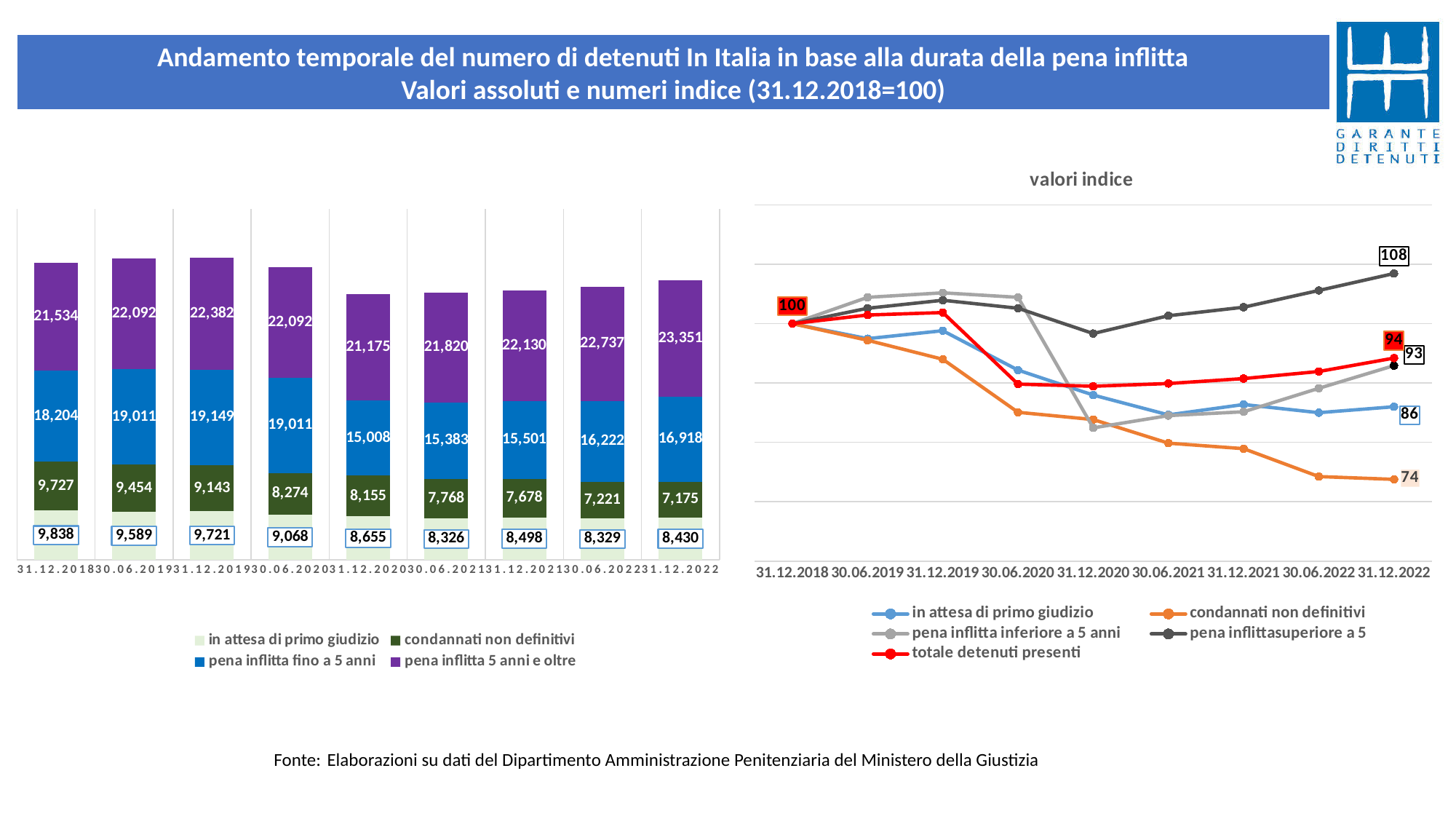
On the left stacked bar chart, what is the value for 'pena inflitta fino a 5 anni' at 31.12.2020? 15,008 On the left stacked bar chart, at which date is 'pena inflitta 5 anni e oltre' highest? 31.12.2022 On the left stacked bar chart, how many dates are shown on the x axis? 9 On the left stacked bar chart, what is the total of the stacked bar for 31.12.2018? 59,303 How many series does the legend of the 'valori indice' chart list? 5 On the left stacked bar chart, which is larger: 'pena inflitta fino a 5 anni' at 30.06.2019 or at 30.06.2022? 30.06.2019 On the 'valori indice' chart, which series has the highest value at 31.12.2022? pena inflitta superiore a 5 On the 'valori indice' chart, what is the index value for 'condannati non definitivi' at 31.12.2022? 74 On the left stacked bar chart, what is the value for 'in attesa di primo giudizio' at 31.12.2018? 9,838 On the left stacked bar chart, what is the difference between 'pena inflitta 5 anni e oltre' at 31.12.2022 and at 31.12.2018? 1,817 On the left stacked bar chart, at which date is 'condannati non definitivi' lowest? 31.12.2022 On the left stacked bar chart, what is the value for 'pena inflitta 5 anni e oltre' at 31.12.2022? 23,351